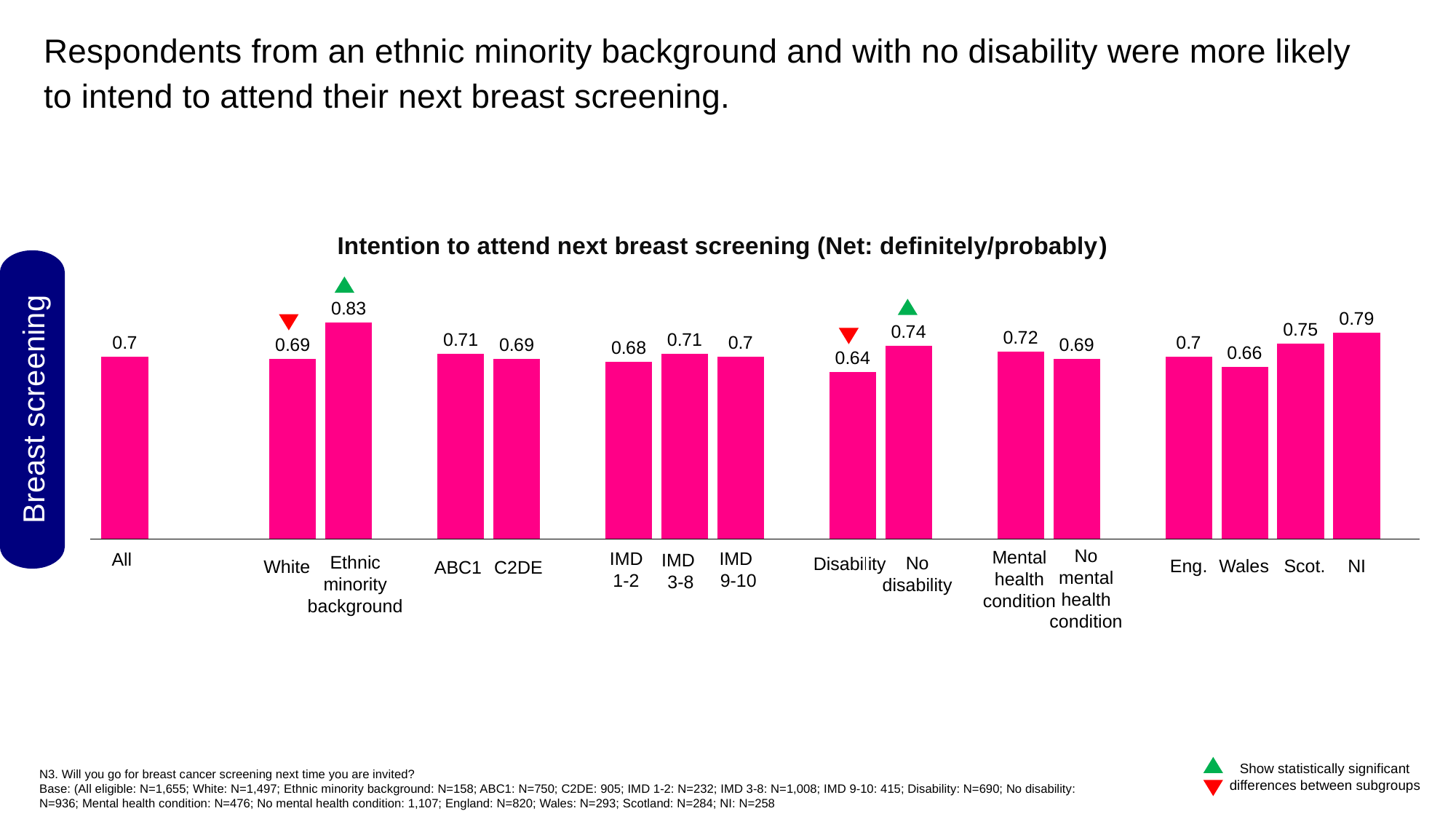
What is the title of the chart? Intention to attend next breast screening (Net: definitely/probably) Which category has the lowest value? Disability What is the value for NI? 0.79 What type of chart is shown? Bar chart What is the value for IMD 1-2? 0.68 How many bars are plotted in the chart? 16 What is the difference between the values for NI and Wales? 0.13 What is the value for Ethnic minority background? 0.83 Which is larger, the value for Scot. or the value for Eng.? Scot. What is the value for Disability? 0.64 What is the difference between the values for No disability and Disability? 0.1 Which category has the highest value? Ethnic minority background